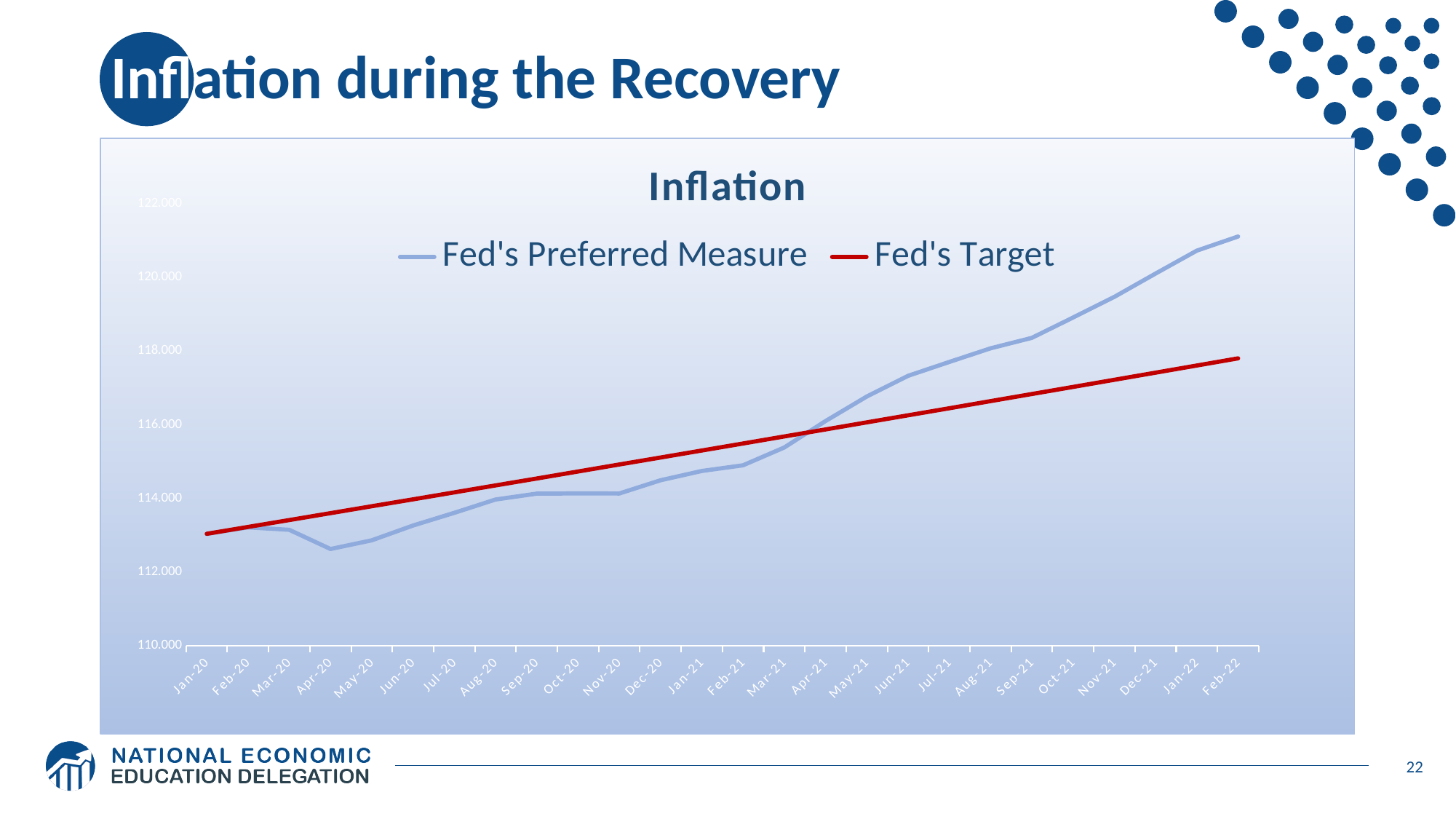
Which series is drawn in red in the Inflation chart? Fed's Target How many monthly points are plotted along the x axis of the Inflation chart? 26 What kind of chart is shown on the slide? line chart What is the title of the chart? Inflation How many series does the legend of the Inflation chart list? 2 In Feb-22, which is larger: Fed's Preferred Measure or Fed's Target? Fed's Preferred Measure Is the value of Fed's Preferred Measure in Apr-20 greater or less than 114.000? less At which month does the Fed's Preferred Measure reach its highest value? Feb-22 Does the Fed's Target line rise or fall from Jan-20 to Feb-22? rise At which month does the Fed's Preferred Measure reach its lowest value? Apr-20 Is the value of Fed's Preferred Measure in Feb-22 greater or less than 120.000? greater In Apr-20, which is larger: Fed's Preferred Measure or Fed's Target? Fed's Target